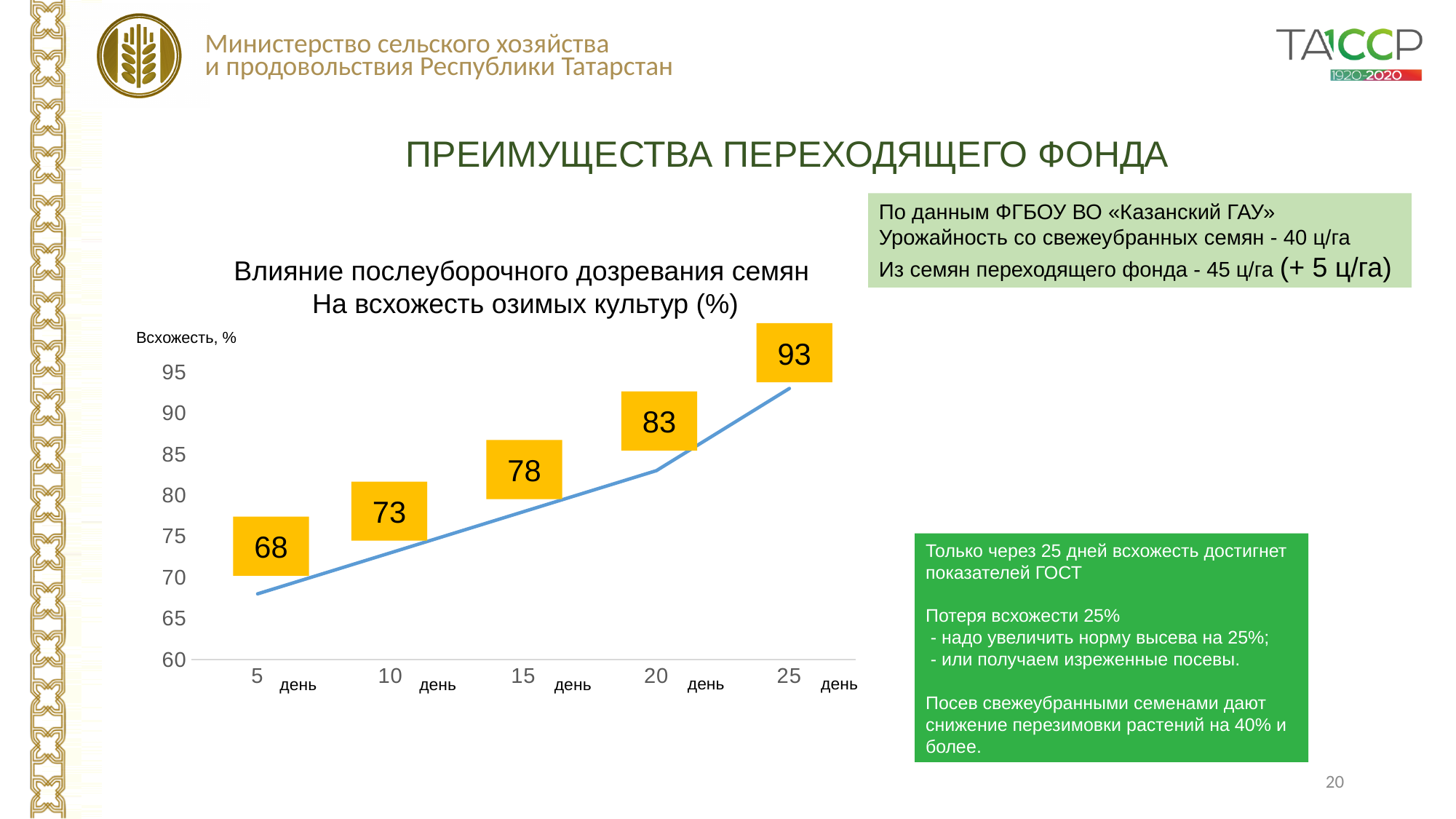
What is the germination value (%) on day 5? 68 What is the difference between the germination values on day 25 and day 5? 25 What is the germination value (%) on day 15? 78 Do the germination values rise or fall from day 5 to day 25? rise What is the germination value (%) on day 25? 93 How many data points are plotted on the chart? 5 On which day is germination lowest? 5 день What is the difference between the germination values on day 20 and day 15? 5 Is the germination value on day 20 greater or less than 80? greater Which is larger, the germination value on day 10 or on day 20? day 20 What kind of chart is shown on the slide? line chart On which day is germination highest? 25 день